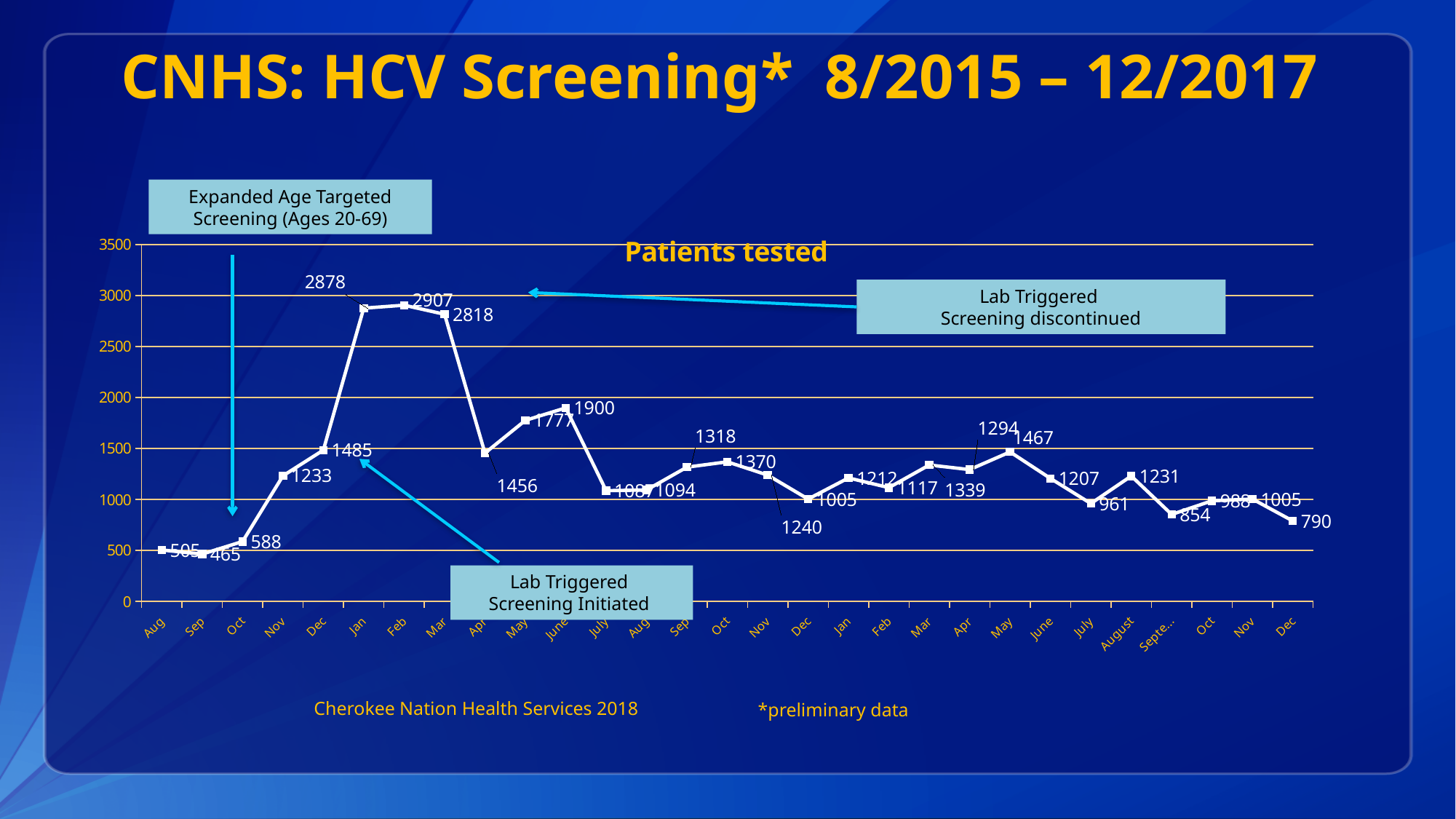
What is the value for the month labelled 'August'? 1231 Which is larger, the value for the first Nov (1233) or the value for the first Dec (1485)? Dec (1485) Which month has the lowest number of patients tested? Sep (first Sep, 465) Which month has the highest number of patients tested? Feb (first Feb, 2907) How many data points are plotted on the line? 29 What is the value for the last Dec on the x axis? 790 What is the title of the chart? Patients tested What is the difference between the first Feb value (2907) and the first Jan value (2878)? 29 What is the value for the first Feb on the x axis? 2907 How many patients were tested in the first Jan shown on the x axis? 2878 What kind of chart is shown on the slide? line chart Is the value for the last Dec on the x axis greater or less than 1000? less